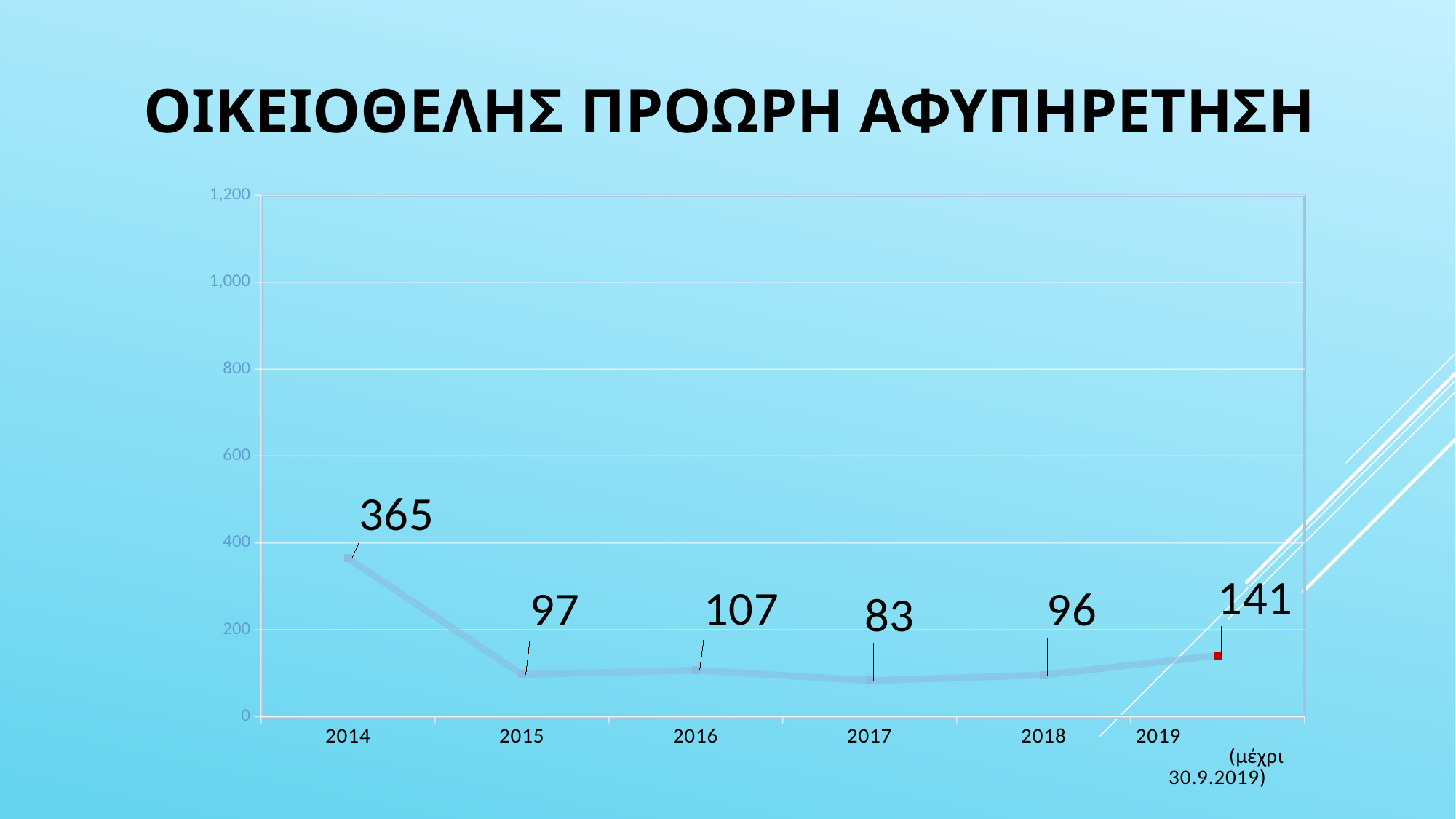
Which year has the lowest value? 2017 What is the value for 2017? 83 What is the value for 2019? 141 Which year has the highest value? 2014 What is the difference between the values for 2014 and 2015? 268 Which is larger, the value for 2016 or the value for 2018? 2016 How many years are plotted on the chart? 6 What is the title of the slide? ΟΙΚΕΙΟΘΕΛΗΣ ΠΡΟΩΡΗ ΑΦΥΠΗΡΕΤΗΣΗ Is the value for 2014 greater or less than 200? greater What is the difference between the values for 2019 and 2018? 45 What kind of chart is shown on the slide? line chart What is the value for 2014? 365